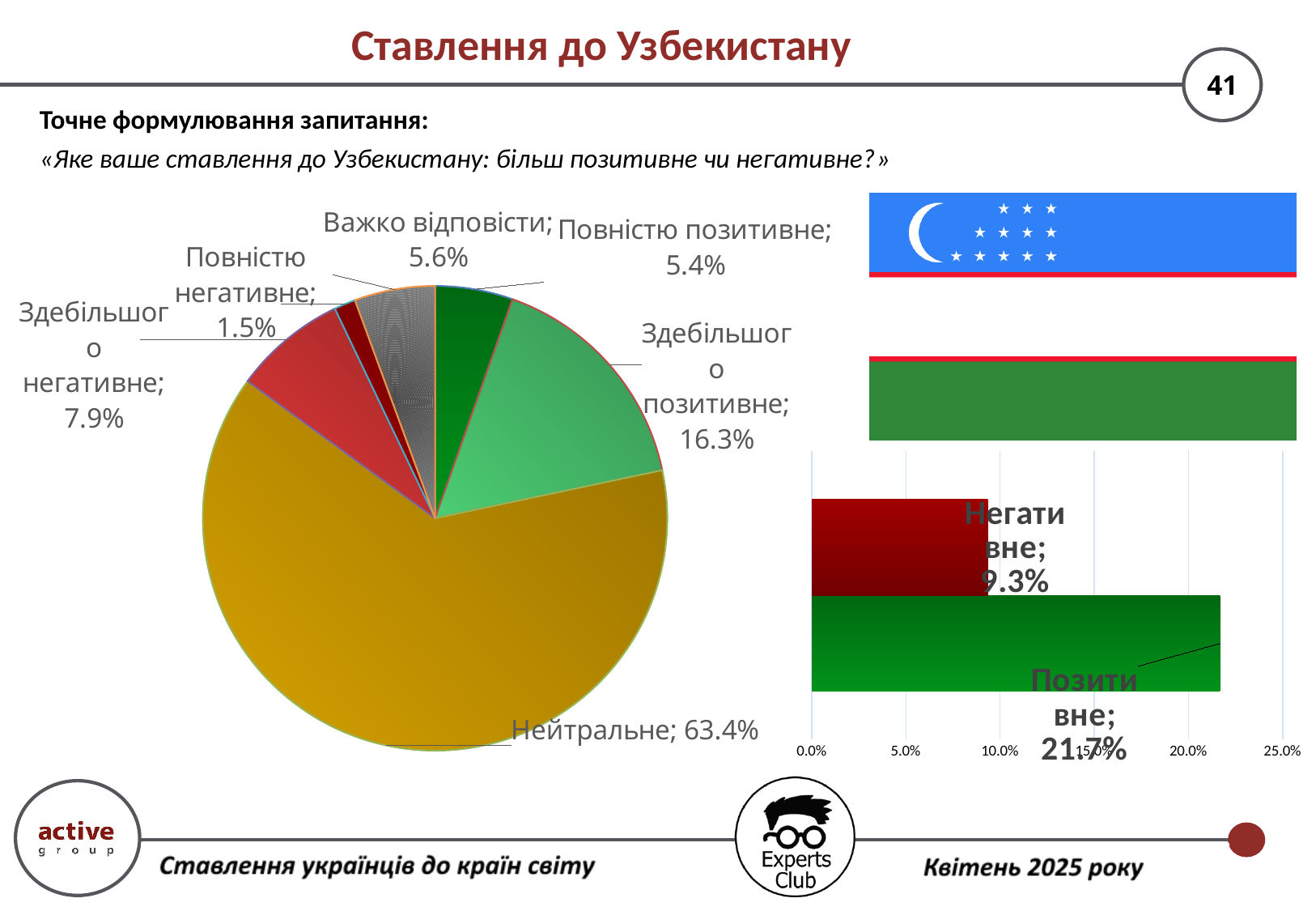
In the pie chart on the left, which is larger: "Важко відповісти" or "Повністю позитивне"? Важко відповісти In the pie chart on the left, which category has the smallest slice? Повністю негативне In the bar chart on the right, what is the value for "Позитивне"? 21.7% In the pie chart on the left, how many slices are there? 6 In the bar chart on the right, what is the value for "Негативне"? 9.3% In the pie chart on the left, what share is labelled "Нейтральне"? 63.4% In the pie chart on the left, what is the value for "Повністю негативне"? 1.5% In the bar chart on the right, what is the difference between "Позитивне" and "Негативне"? 12.4% What type of chart is shown on the right side of the slide? Bar chart In the pie chart on the left, what is the difference between "Здебільшого позитивне" and "Здебільшого негативне"? 8.4% In the pie chart on the left, what is the value for "Здебільшого позитивне"? 16.3% In the pie chart on the left, which category has the largest slice? Нейтральне